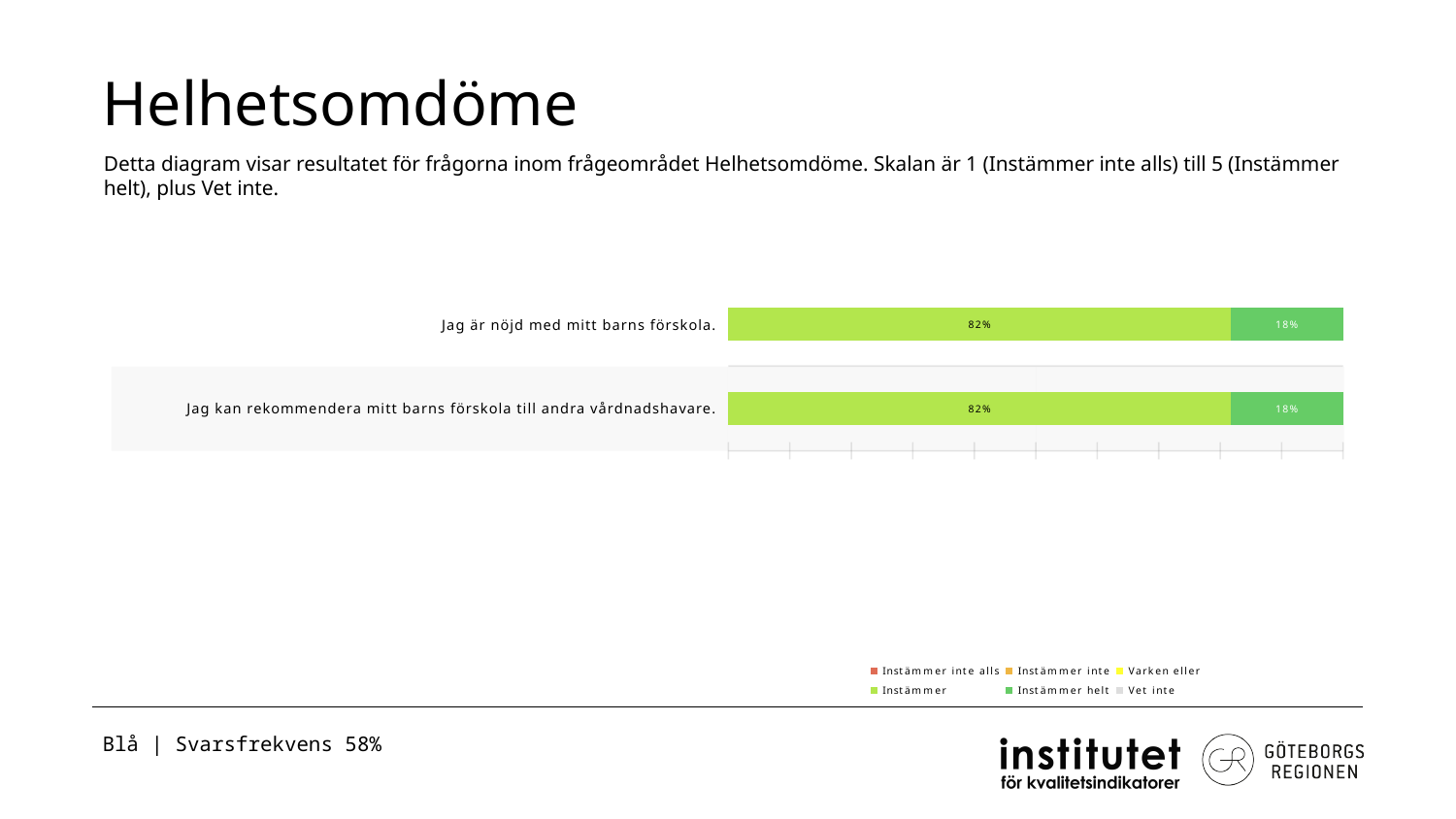
What is the value of "Instämmer" for "Jag kan rekommendera mitt barns förskola till andra vårdnadshavare."? 82% How many series does the legend list? 6 What is the value of "Instämmer helt" for "Jag är nöjd med mitt barns förskola."? 18% What is the title of the slide containing the chart? Helhetsomdöme For "Jag är nöjd med mitt barns förskola.", which is larger: "Instämmer" or "Instämmer helt"? Instämmer What is the difference between the "Instämmer" and "Instämmer helt" values for "Jag kan rekommendera mitt barns förskola till andra vårdnadshavare."? 64% How many categories (questions) are plotted in the chart? 2 What is the total of the stacked bar for "Jag är nöjd med mitt barns förskola."? 100% Which legend entry is shown in red? Instämmer inte alls What kind of chart is shown on the slide? stacked bar chart What is the value of "Instämmer helt" for "Jag kan rekommendera mitt barns förskola till andra vårdnadshavare."? 18% What is the value of "Instämmer" for "Jag är nöjd med mitt barns förskola."? 82%